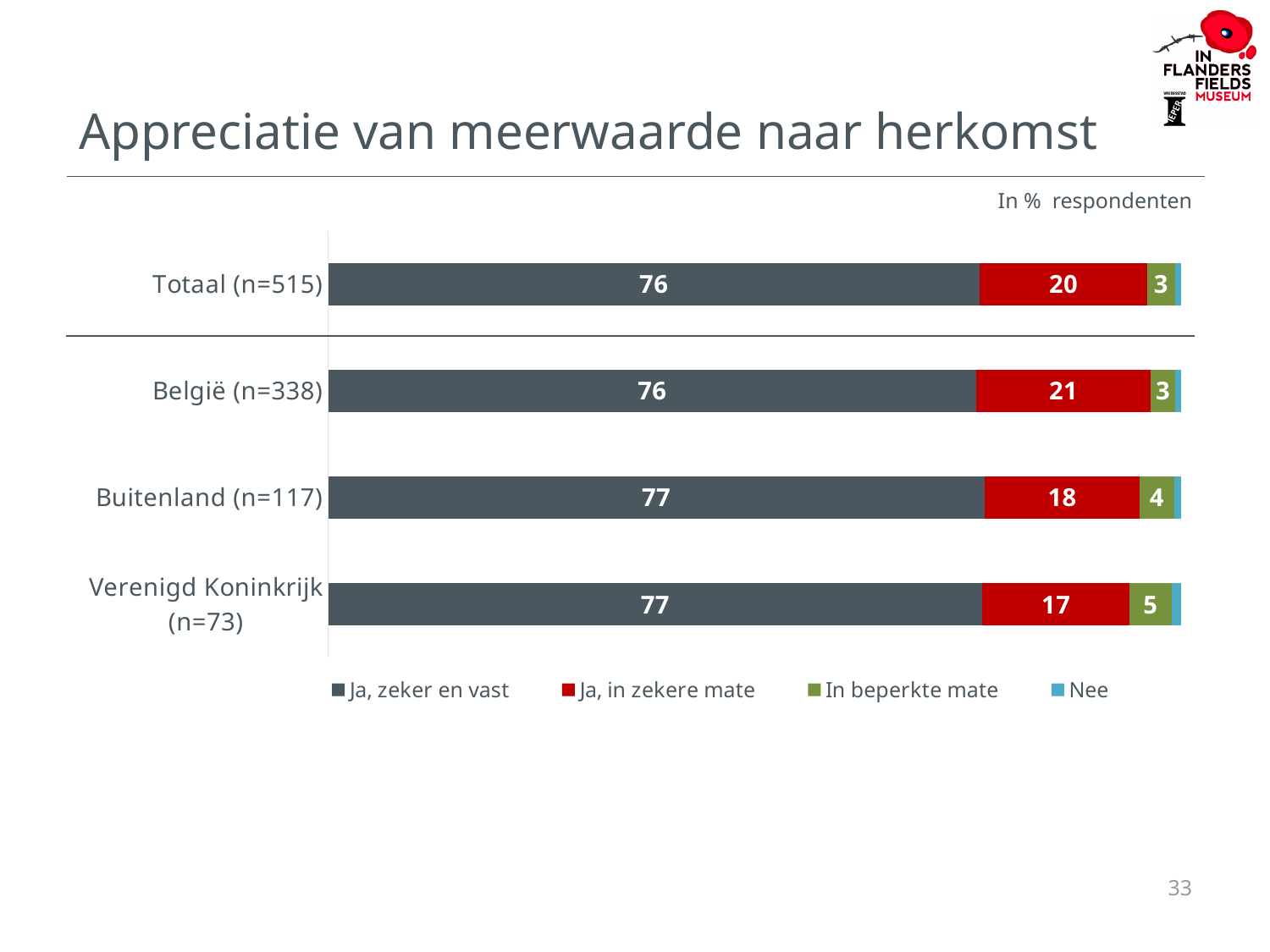
Which category has the highest value for 'Ja, in zekere mate'? België (n=338) Which is larger: the 'In beperkte mate' value for Buitenland (n=117) or for België (n=338)? Buitenland (n=117) Which category has the lowest value for 'Ja, in zekere mate'? Verenigd Koninkrijk (n=73) What is the value of 'Ja, in zekere mate' for Buitenland (n=117)? 18 What is the value of 'Ja, in zekere mate' for België (n=338)? 21 What is the title of the chart on the slide? Appreciatie van meerwaarde naar herkomst How many series does the legend list? 4 What is the difference between the 'Ja, in zekere mate' values for België (n=338) and Verenigd Koninkrijk (n=73)? 4 What kind of chart is shown on the slide? Stacked bar chart How many categories (rows) are plotted in the chart? 4 What is the value of 'In beperkte mate' for Verenigd Koninkrijk (n=73)? 5 What is the value of 'Ja, zeker en vast' for Totaal (n=515)? 76